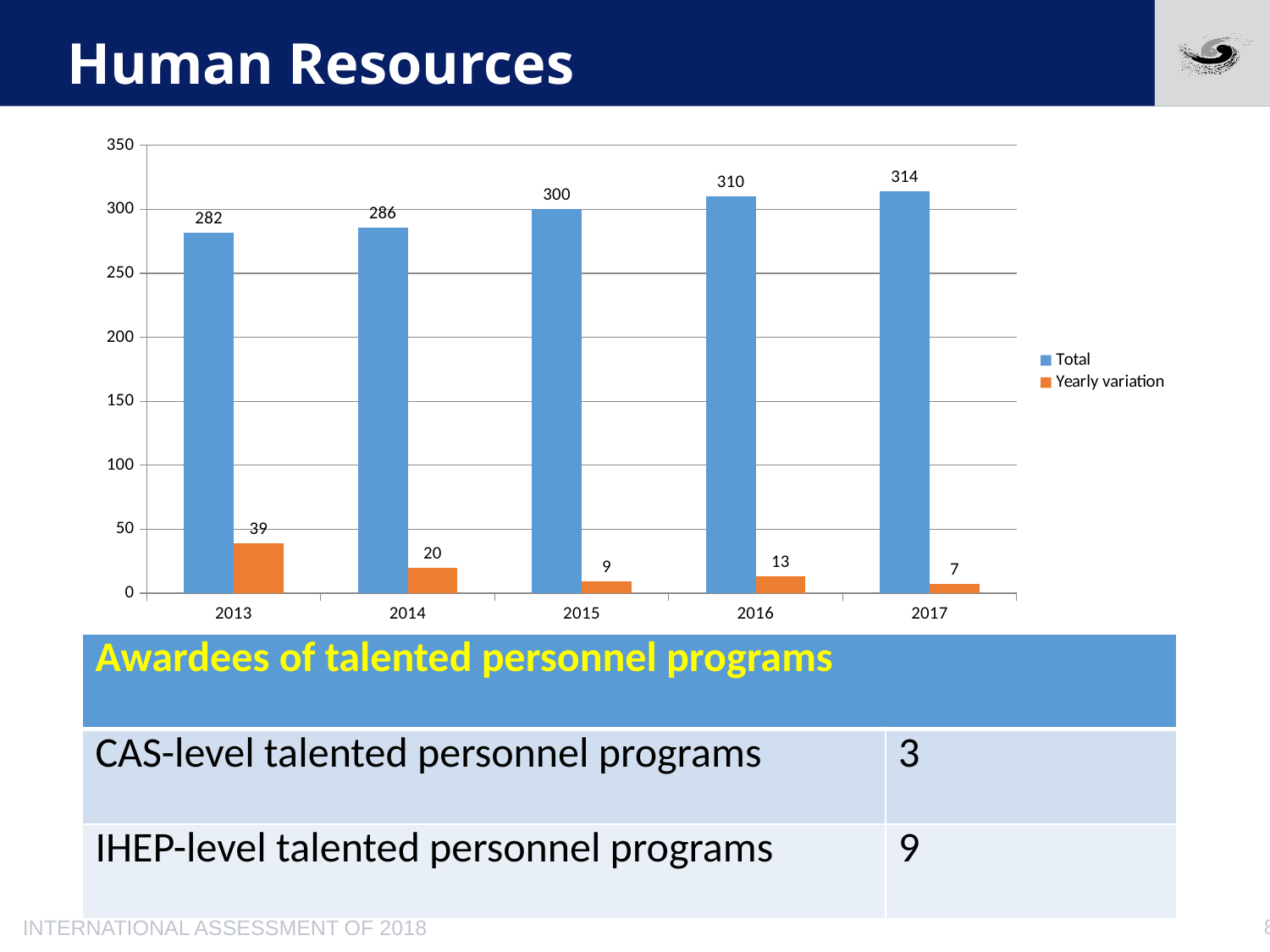
What is the difference between the Total values for 2017 and 2013? 32 Which year has the highest Total value? 2017 Which year has the lowest Yearly variation value? 2017 How many series does the chart legend list? 2 How many years are shown on the x axis of the chart? 5 What kind of chart is shown on the slide? bar chart What is the Yearly variation value for 2013? 39 Does the Total series rise or fall from 2013 to 2017? rise Which is larger, the Yearly variation for 2014 or for 2016? 2014 What is the Yearly variation value for 2017? 7 What is the Total value for 2015? 300 Is the Total value for 2014 greater or less than 300? less